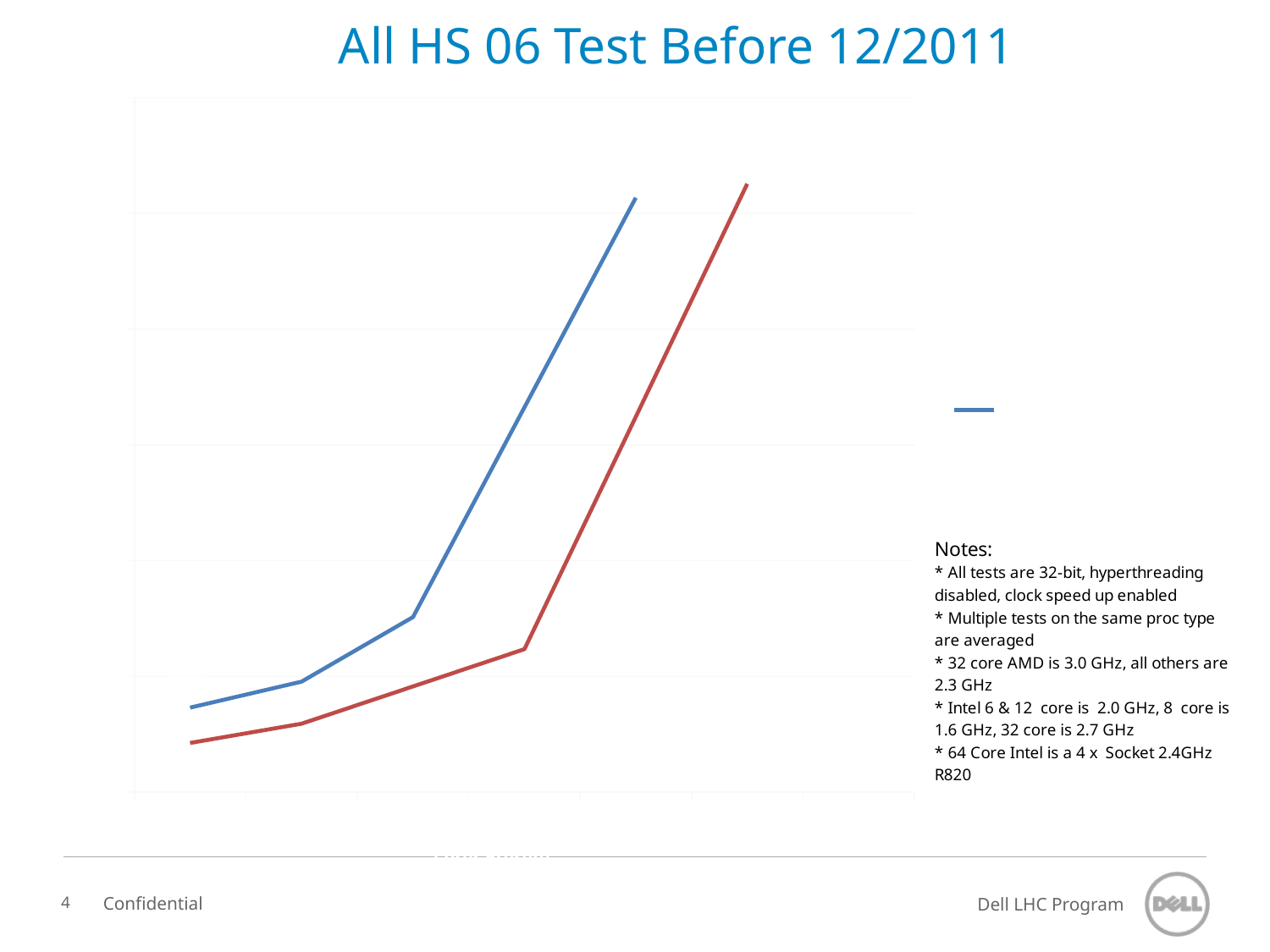
What is the title shown above the chart? All HS 06 Test Before 12/2011 How many lines are plotted on the chart? 2 Do the values of the blue line rise or fall from left to right? rise How many data points does the blue line have? 4 Which line reaches the higher value at its final (rightmost) point, the blue line or the red line? red line Do the values of the red line rise or fall from left to right? rise At the first (leftmost) point, which line has the higher value, the blue line or the red line? blue line What colours are the two lines on the chart? blue and red What kind of chart is shown on the slide? line chart